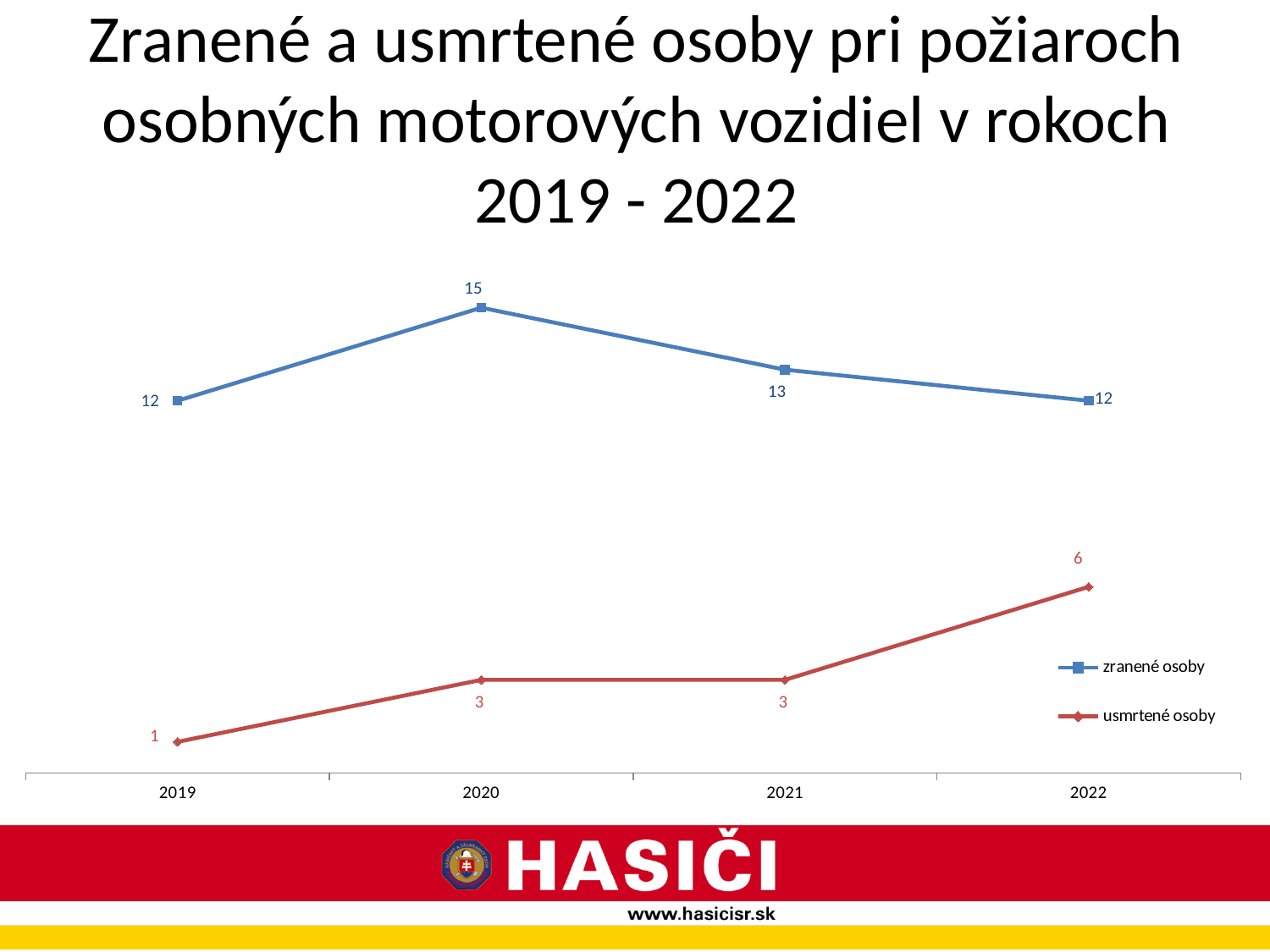
How many years are shown on the x axis? 4 What value does the 'zranené osoby' series show for 2021? 13 How many series does the legend list? 2 What value does the 'usmrtené osoby' series show for 2019? 1 In which year is the 'usmrtené osoby' series lowest? 2019 Does the 'usmrtené osoby' series rise or fall from 2019 to 2022? rise What value does the 'zranené osoby' series show for 2020? 15 What value does the 'usmrtené osoby' series show for 2022? 6 What is the difference between the 'zranené osoby' values for 2020 and 2022? 3 In which year is the 'zranené osoby' series highest? 2020 What kind of chart is shown on the slide? line chart Which is larger: the 'usmrtené osoby' value for 2021 or for 2022? 2022